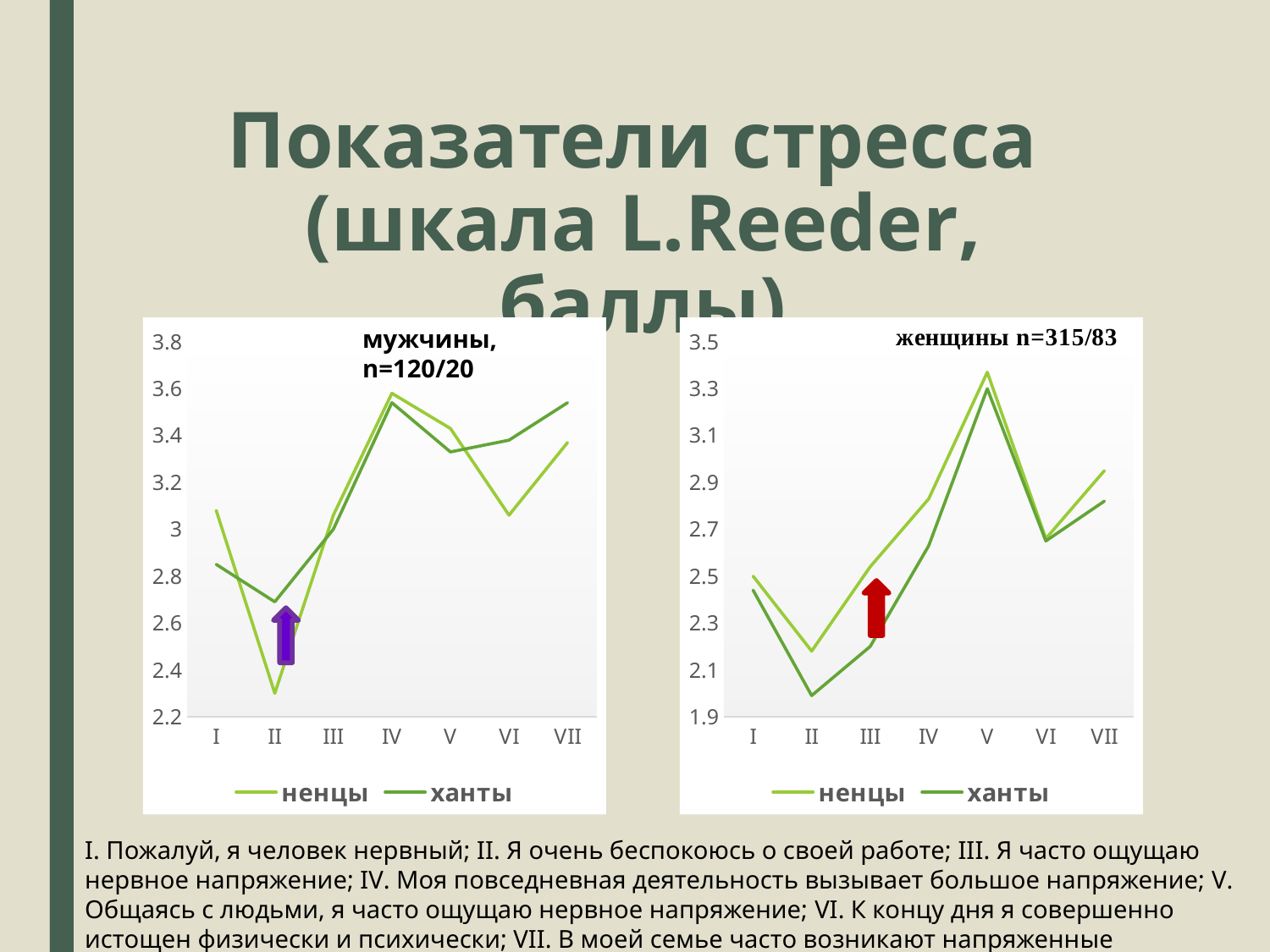
In the right chart ("женщины n=315/83"), at which category is the ханты line highest? V In the left chart ("мужчины, n=120/20"), at which category is the ненцы line lowest? II In the right chart ("женщины n=315/83"), is the value for ханты at category II greater or less than 2.1? less How many series does the legend of the right chart ("женщины n=315/83") list? 2 In the left chart ("мужчины, n=120/20"), is the value for ненцы at category IV greater or less than 3.4? greater In the right chart ("женщины n=315/83"), does the ненцы line rise or fall from category II to category V? rise How many categories are shown on the x axis of the left chart ("мужчины, n=120/20")? 7 In the left chart ("мужчины, n=120/20"), which series has the larger value at category II, ненцы or ханты? ханты What kind of chart is the left chart titled "мужчины, n=120/20"? line chart What are the two legend entries of the left chart ("мужчины, n=120/20")? ненцы, ханты In the right chart ("женщины n=315/83"), which series has the larger value at category III, ненцы or ханты? ненцы In the left chart ("мужчины, n=120/20"), is the value for ненцы at category II greater or less than 2.4? less